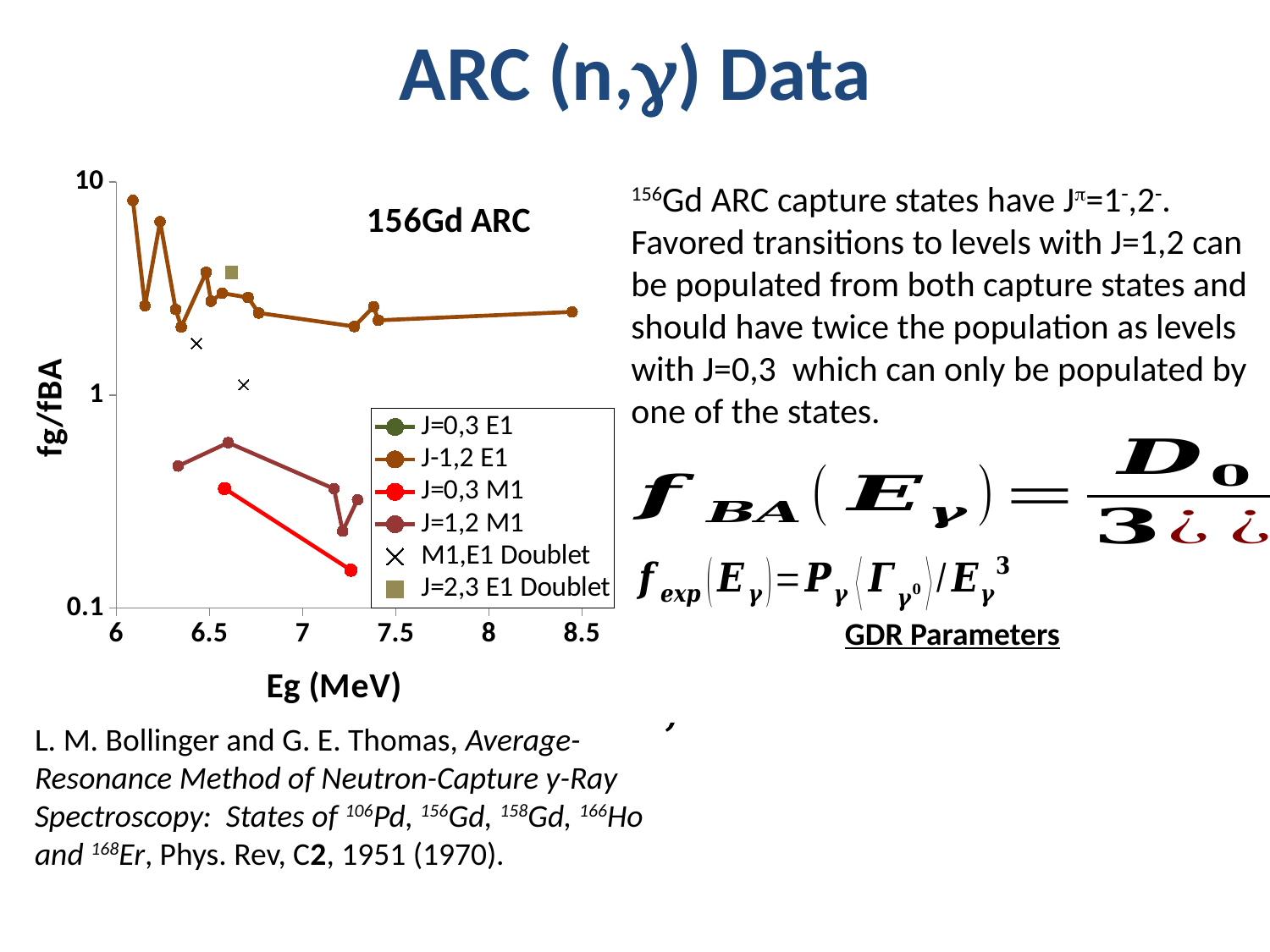
Are the values of the J=0,3 M1 series greater or less than 1? less What kind of chart is shown on the slide? line chart How many data points are plotted for the J=0,3 M1 series? 2 How many data points are plotted for the J=2,3 E1 Doublet series? 1 How many M1,E1 Doublet points are plotted on the chart? 2 What is the label of the x axis of the chart? Eg (MeV) Do the values of the J=0,3 M1 series rise or fall as Eg increases? fall Is the value of the J=2,3 E1 Doublet point greater or less than 1? greater What is the title of the chart? 156Gd ARC How many series does the chart legend list? 6 Which series has the lowest values on the chart, J-1,2 E1 or J=0,3 M1? J=0,3 M1 Is the highest value of the J-1,2 E1 series greater or less than 10? less